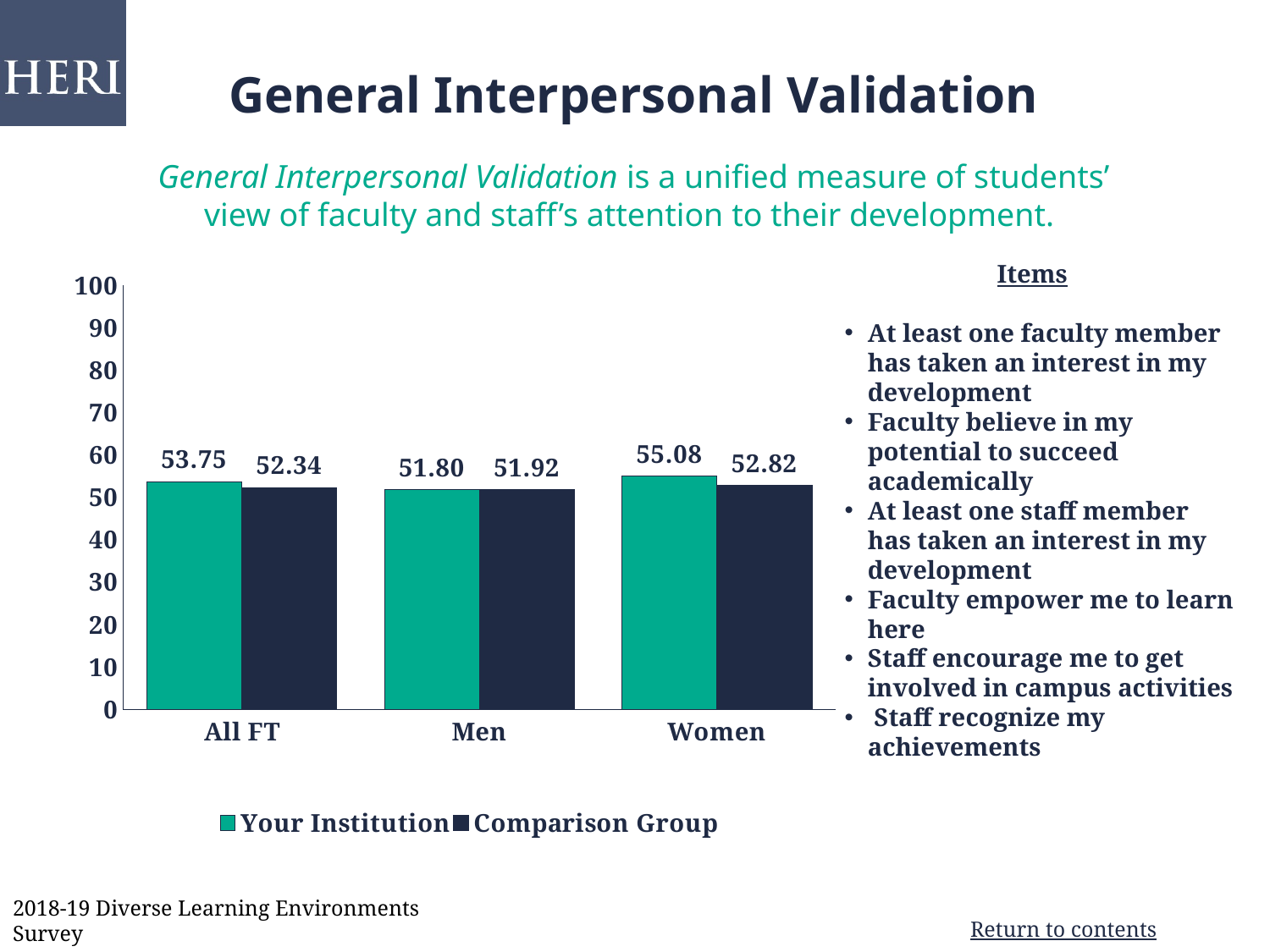
Which series is shown in dark navy in the legend? Comparison Group What is the value for Comparison Group in the All FT category? 52.34 Which category has the lowest value for Your Institution? Men What is the value for Your Institution in the Men category? 51.80 What is the difference between Your Institution and Comparison Group for Women? 2.26 How many series does the legend list? 2 Which category has the highest value for Your Institution? Women How many categories are shown on the x axis? 3 What kind of chart is shown on the slide? bar chart Which is larger for All FT: Your Institution or Comparison Group? Your Institution Is the value for Comparison Group in the Men category greater or less than 60? less What is the value for Your Institution in the Women category? 55.08